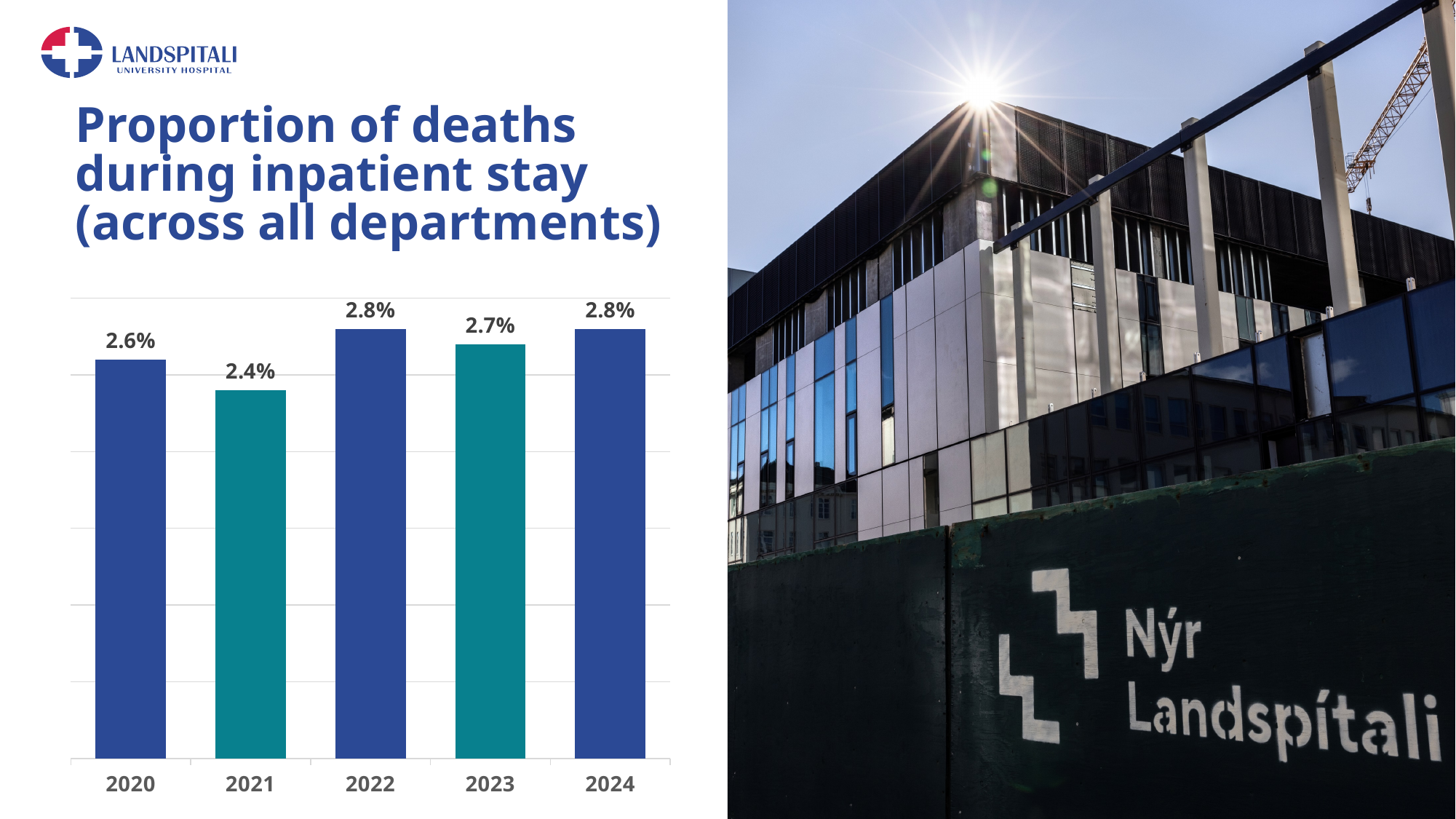
What is the proportion of deaths during inpatient stay in 2023? 2.7% What is the title of the chart? Proportion of deaths during inpatient stay (across all departments) Which year has the larger proportion of deaths, 2023 or 2024? 2024 What kind of chart is shown on the slide? Bar chart What is the proportion of deaths during inpatient stay in 2020? 2.6% What is the difference between the proportion of deaths in 2023 and in 2020? 0.1% Which year has the lowest proportion of deaths during inpatient stay? 2021 What is the proportion of deaths during inpatient stay in 2024? 2.8% What is the difference between the proportion of deaths in 2022 and in 2021? 0.4% How many years are shown on the chart? 5 Which year has the larger proportion of deaths, 2020 or 2021? 2020 What is the proportion of deaths during inpatient stay in 2021? 2.4%